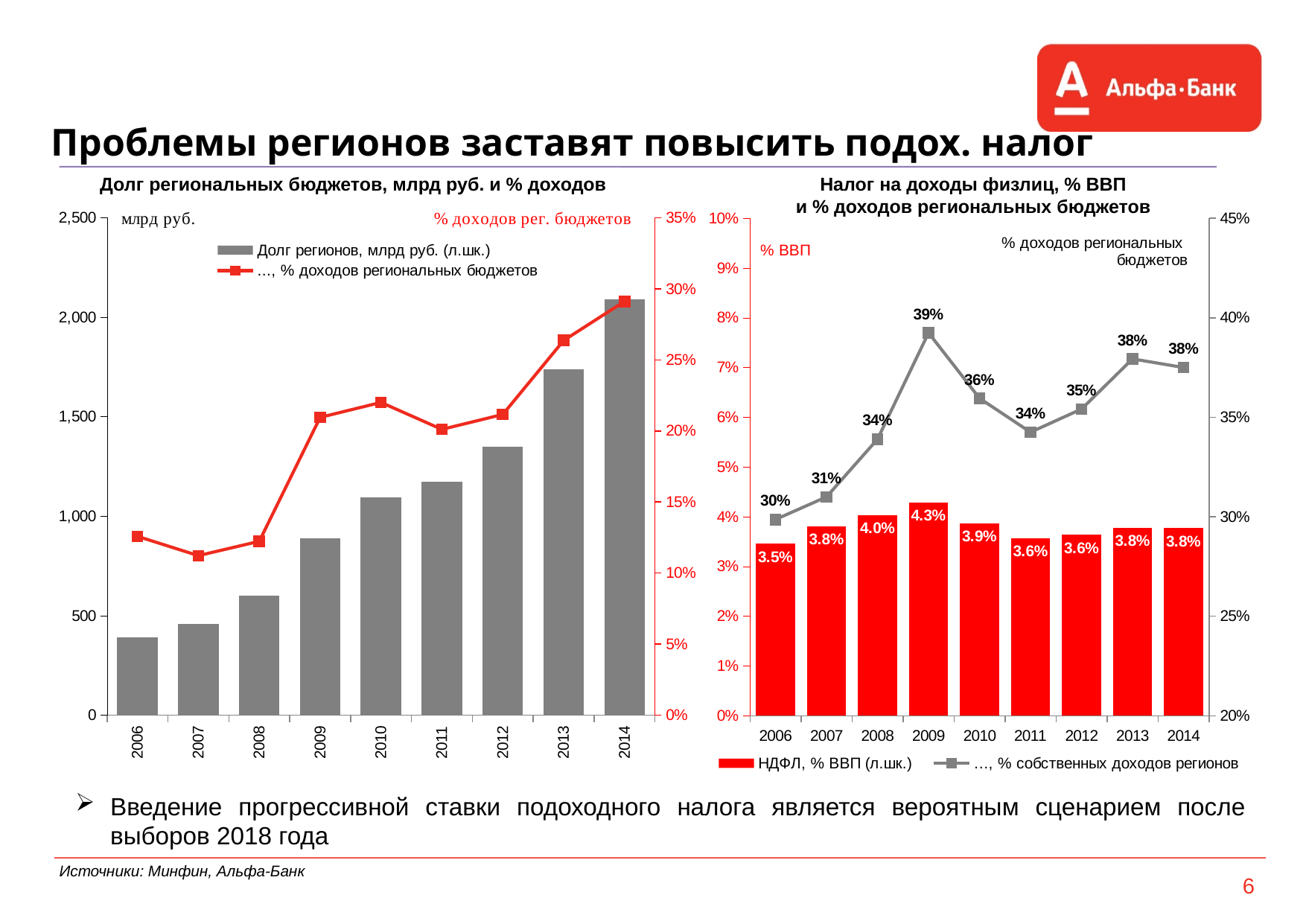
In the chart 'Долг региональных бюджетов, млрд руб. и % доходов', how many series does the legend list? 2 In the chart 'Долг региональных бюджетов, млрд руб. и % доходов', is the '% доходов региональных бюджетов' value for 2014 greater or less than 25%? greater In the chart 'Налог на доходы физлиц, % ВВП и % доходов региональных бюджетов', what is the difference between НДФЛ, % ВВП in 2009 and in 2006? 0.8% In the chart 'Долг региональных бюджетов, млрд руб. и % доходов', is the value of Долг регионов for 2006 greater or less than 500? less In the chart 'Долг региональных бюджетов, млрд руб. и % доходов', do the Долг регионов bars generally rise or fall from 2006 to 2014? rise In the chart 'Налог на доходы физлиц, % ВВП и % доходов региональных бюджетов', what is the value of the '% собственных доходов регионов' line for 2009? 39% In the chart 'Налог на доходы физлиц, % ВВП и % доходов региональных бюджетов', which is larger: НДФЛ, % ВВП in 2008 or in 2011? 2008 In the chart 'Долг региональных бюджетов, млрд руб. и % доходов', is the value of Долг регионов for 2014 greater or less than 2,000? greater In the chart 'Налог на доходы физлиц, % ВВП и % доходов региональных бюджетов', what is the value of НДФЛ, % ВВП for 2009? 4.3% In the chart 'Налог на доходы физлиц, % ВВП и % доходов региональных бюджетов', which year has the lowest value on the '% собственных доходов регионов' line? 2006 In the chart 'Налог на доходы физлиц, % ВВП и % доходов региональных бюджетов', which year has the highest НДФЛ, % ВВП? 2009 In the chart 'Налог на доходы физлиц, % ВВП и % доходов региональных бюджетов', how many years are shown on the x axis? 9